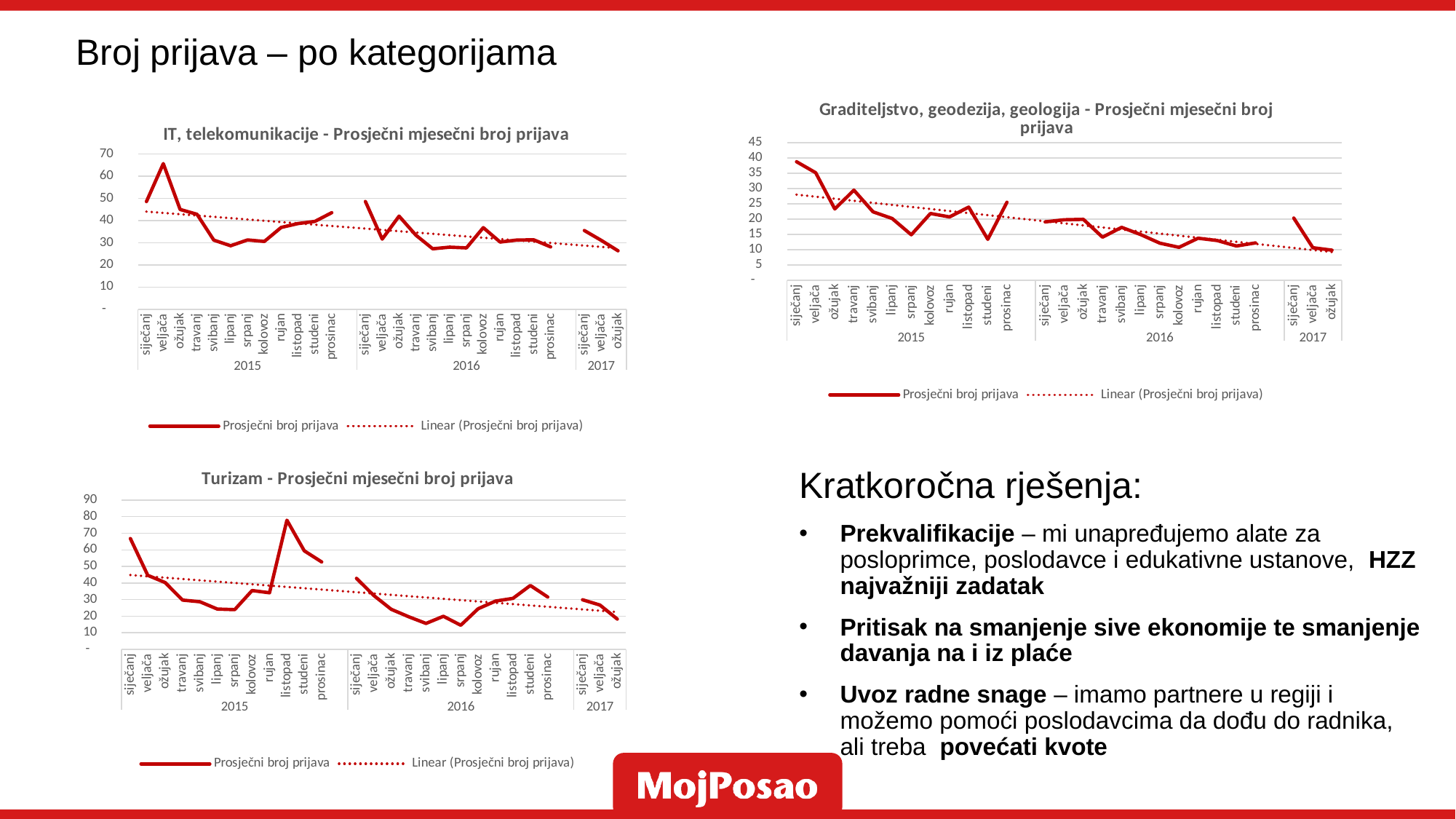
In the 'Graditeljstvo, geodezija, geologija' chart, which month has the highest average number of applications? siječanj 2015 What is the name of the solid-line series in the legend of the 'Graditeljstvo, geodezija, geologija' chart? Prosječni broj prijava In the 'IT, telekomunikacije' chart, which month has the highest average number of applications? veljača 2015 In the 'Turizam' chart, which month has the highest average number of applications? listopad 2015 In the 'Graditeljstvo, geodezija, geologija' chart, is the value for siječanj 2015 greater or less than 35? greater How many series does the legend of the 'Turizam - Prosječni mjesečni broj prijava' chart list? 2 What kind of chart is the 'IT, telekomunikacije - Prosječni mjesečni broj prijava' chart? line chart In the 'Turizam' chart, is the value for listopad 2015 greater or less than 70? greater In the 'IT, telekomunikacije' chart, does the dotted linear trend line rise or fall from 2015 to 2017? fall How many charts are shown on the slide? 3 In the 'IT, telekomunikacije' chart, is the value for veljača 2015 greater or less than 60? greater